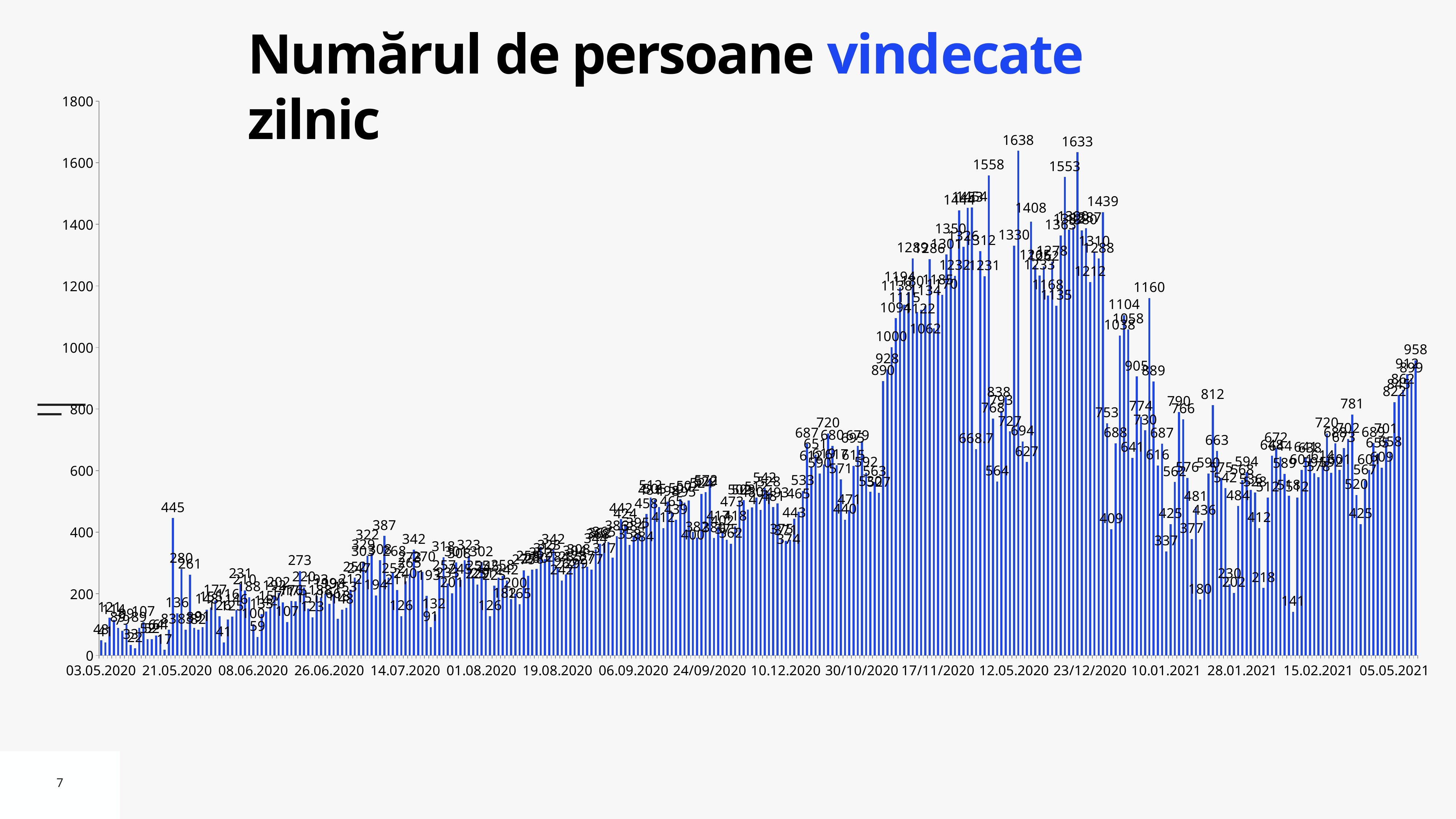
What is the value of the tall isolated bar near 21.05.2020? 445 What is the second-highest value labelled on the chart, near 23/12/2020? 1633 Is the value 1638 greater or less than 1600 on the axis? greater Which is larger, the value 1558 or the value 1408? 1558 Do the values generally rise or fall between 03.05.2020 and 17/11/2020? rise What is the difference between the two highest labelled values, 1638 and 1633? 5 What is the maximum value shown on the vertical axis? 1800 What is the first date label on the horizontal axis? 03.05.2020 What is the highest value labelled on the chart? 1638 What is the value of the last bar on the chart, near 05.05.2021? 958 What is the title of the chart? Numărul de persoane vindecate zilnic What kind of chart is shown on the slide? bar chart